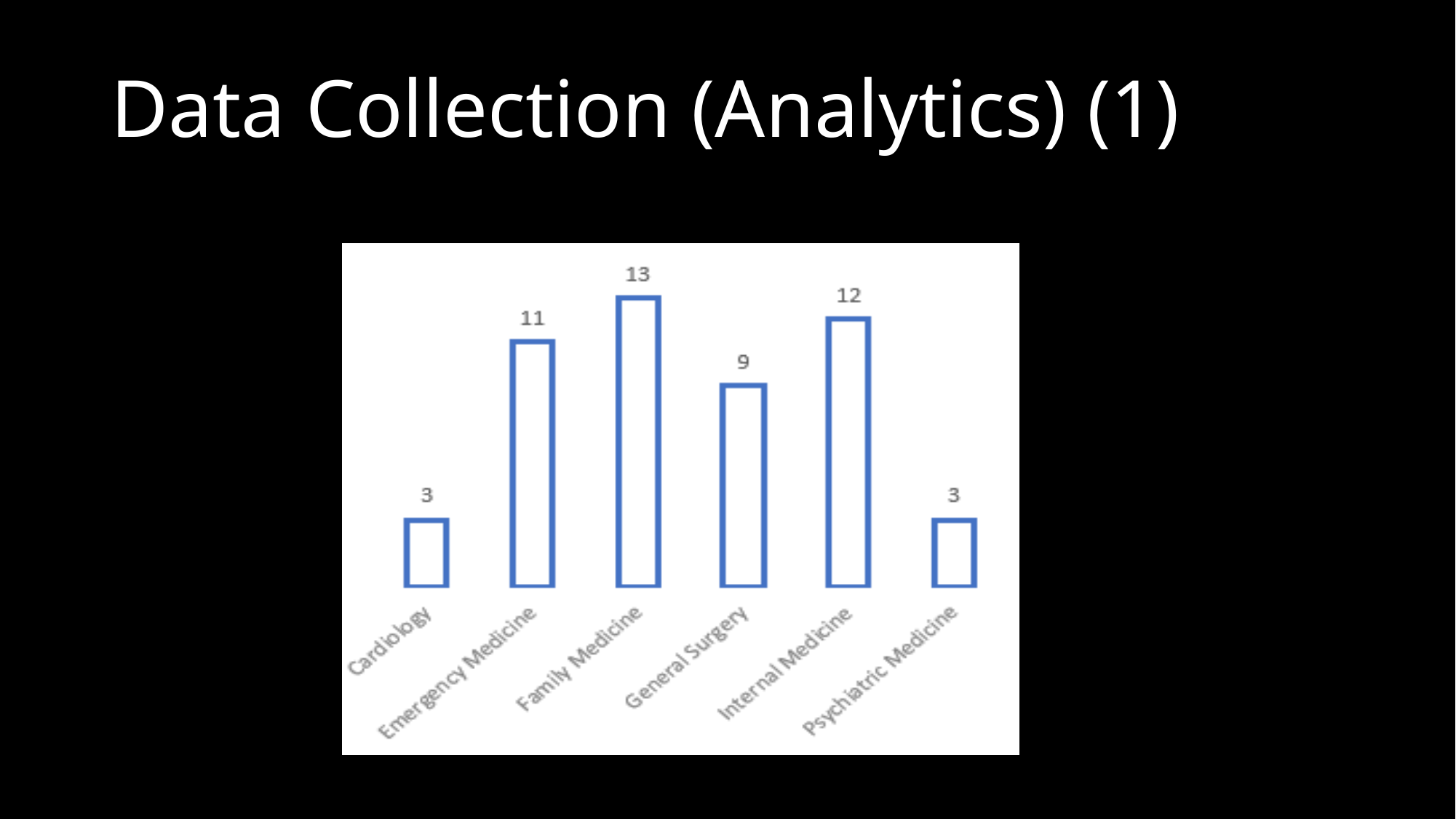
How many categories are shown in the chart? 6 What is the difference between the values for Internal Medicine and Cardiology? 9 What is the value for Internal Medicine? 12 What kind of chart is shown on the slide? Bar chart What is the difference between the values for Family Medicine and General Surgery? 4 Which is larger, the value for Emergency Medicine or the value for General Surgery? Emergency Medicine Which category has the highest value? Family Medicine What is the value for Emergency Medicine? 11 What is the title of the slide containing the chart? Data Collection (Analytics) (1) What is the value for General Surgery? 9 What is the value for Family Medicine? 13 What is the value for Cardiology? 3